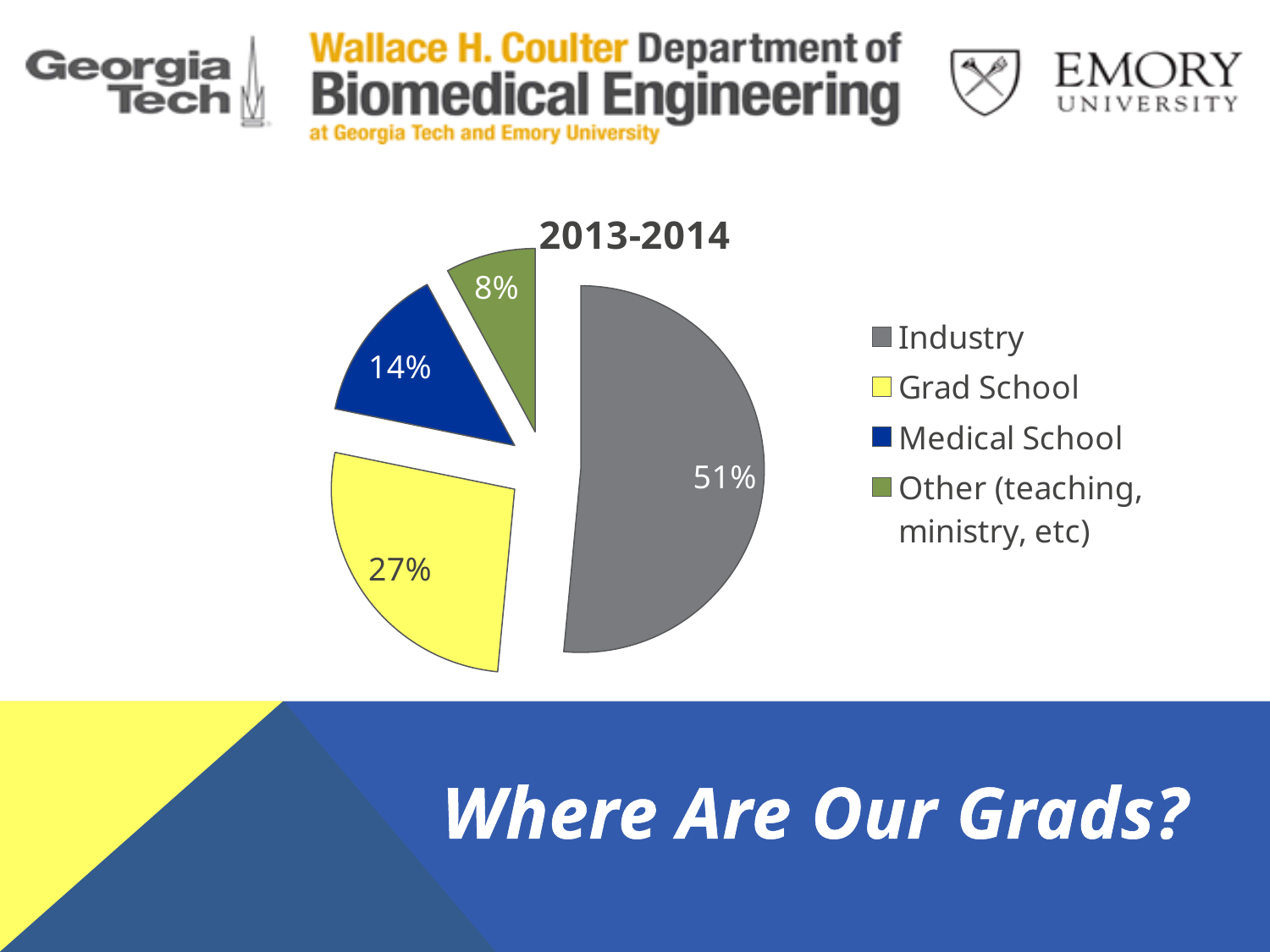
What percentage of grads fall under Other (teaching, ministry, etc)? 8% What percentage of grads went into Industry? 51% What is the difference in percentage points between Industry and Grad School? 24 What colour is the Medical School slice? blue Which is larger, the share for Medical School or the share for Grad School? Grad School What is the title of the chart? 2013-2014 Which category has the largest share of the pie? Industry What percentage of grads went to Grad School? 27% Which category has the smallest share of the pie? Other (teaching, ministry, etc) How many categories does the legend list? 4 What percentage of grads went to Medical School? 14% What type of chart is shown on the slide? pie chart